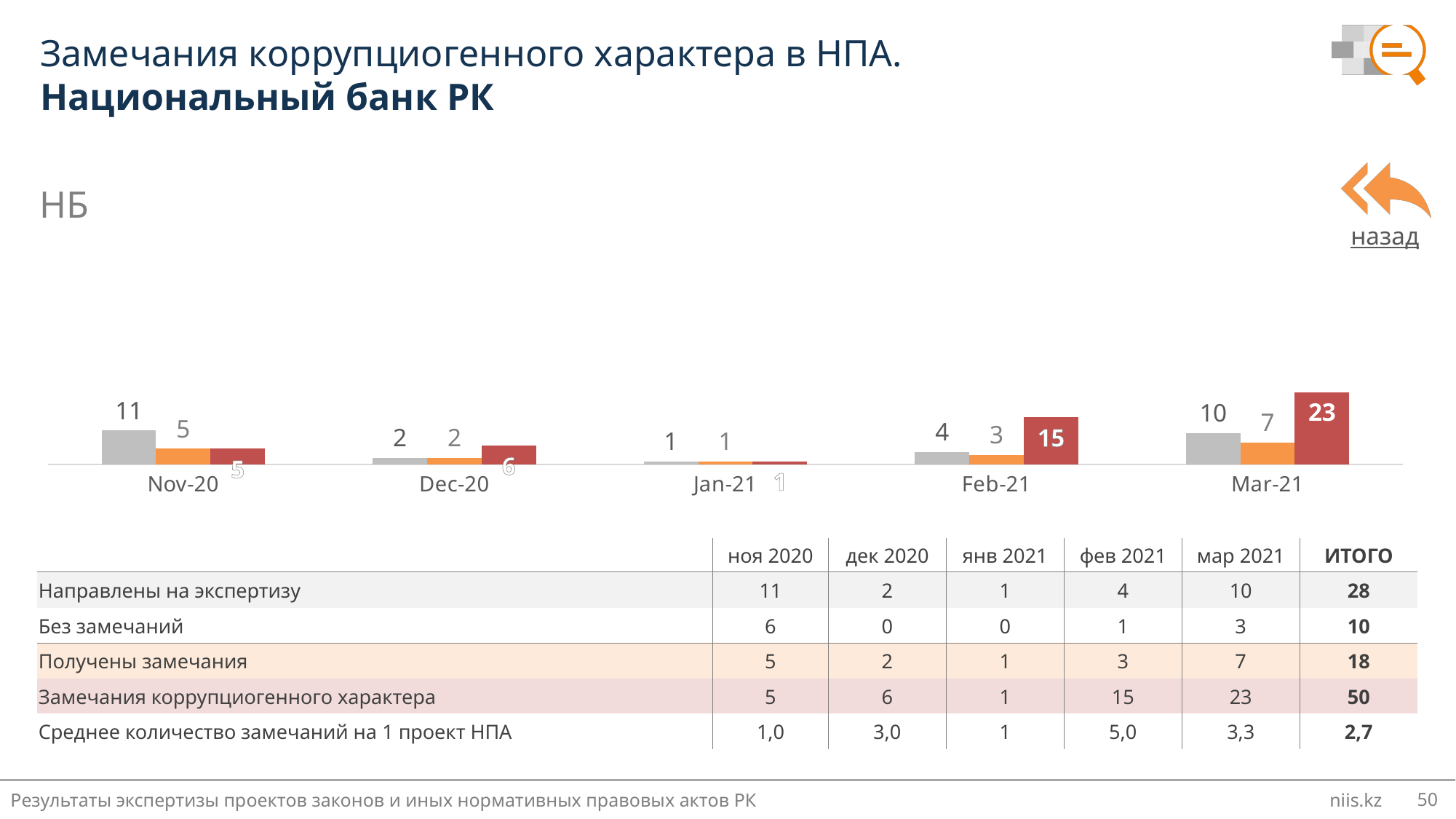
What is the value of the gray bar for Nov-20? 11 Which is larger for Nov-20: the gray bar or the red bar? the gray bar What is the value of the orange bar for Feb-21? 3 What is the value of the red bar for Feb-21? 15 How many month categories are shown on the x axis of the chart? 5 In which month is the gray bar the lowest? Jan-21 What is the value of the red bar for Mar-21? 23 What kind of chart is shown on the slide? bar chart How many bars are shown for each month in the chart? 3 Does the red bar rise or fall from Jan-21 to Mar-21? rise What is the difference between the red bar values for Mar-21 and Feb-21? 8 In which month is the red bar the highest? Mar-21